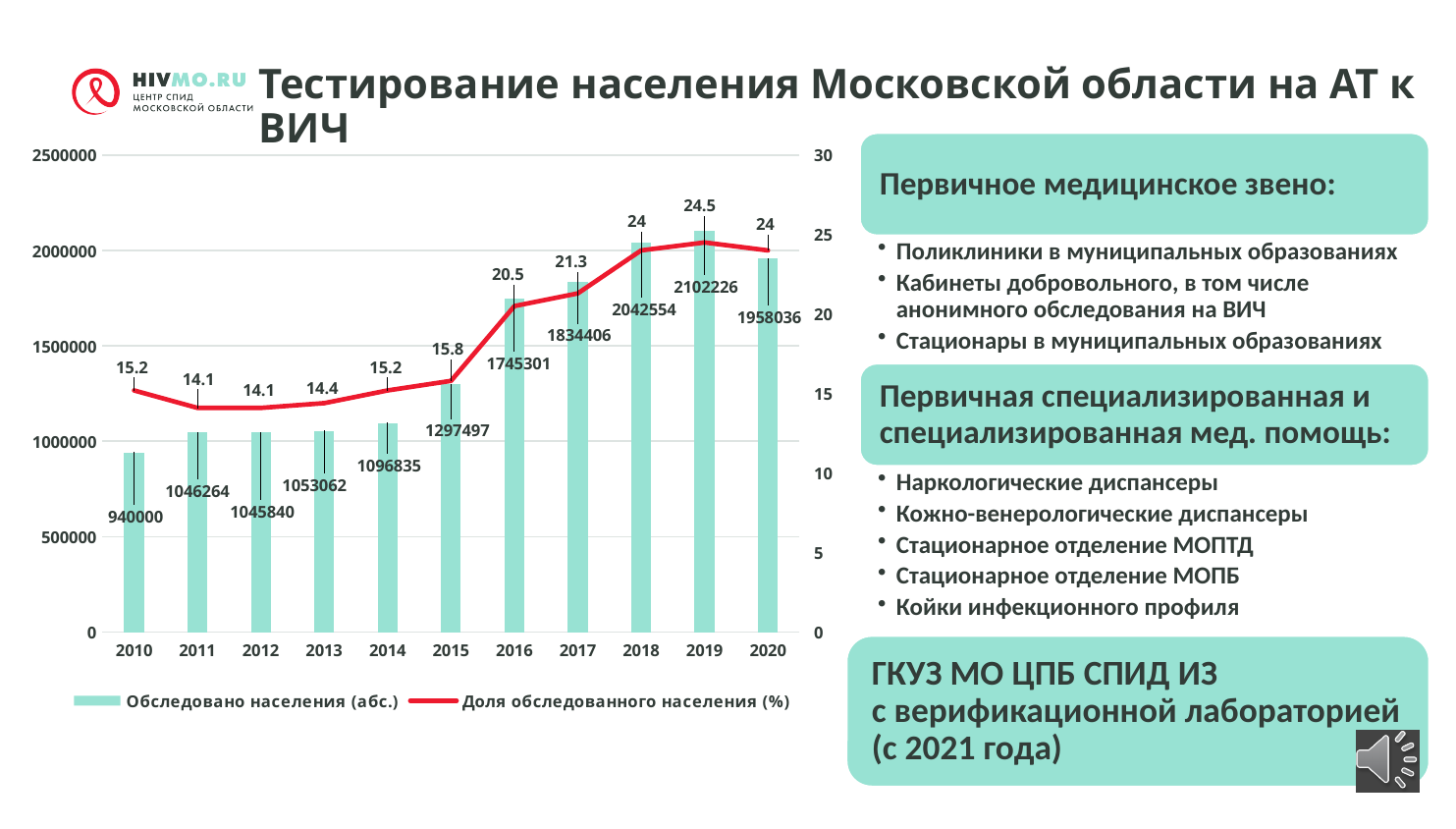
In which year was the number of people tested (Обследовано населения (абс.)) the highest? 2019 By how many percentage points did the share of the population tested increase from 2010 to 2018? 8.8 In which year was the share of the population tested (Доля обследованного населения (%)) the highest? 2019 How many series does the chart legend list? 2 What was the share of the population tested (Доля обследованного населения (%)) in 2017? 21.3 How many years are shown on the x axis of the chart? 11 What is the overall trend of the share of the population tested (Доля обследованного населения (%)) from 2013 to 2019? Rising In which year was the number of people tested (Обследовано населения (абс.)) the lowest? 2010 What kind of chart is shown on the slide? Combined bar and line chart What is the difference between the number of people tested in 2019 and in 2020? 144190 How many people were tested (Обследовано населения (абс.)) in 2016? 1745301 Which year had more people tested, 2015 or 2016? 2016